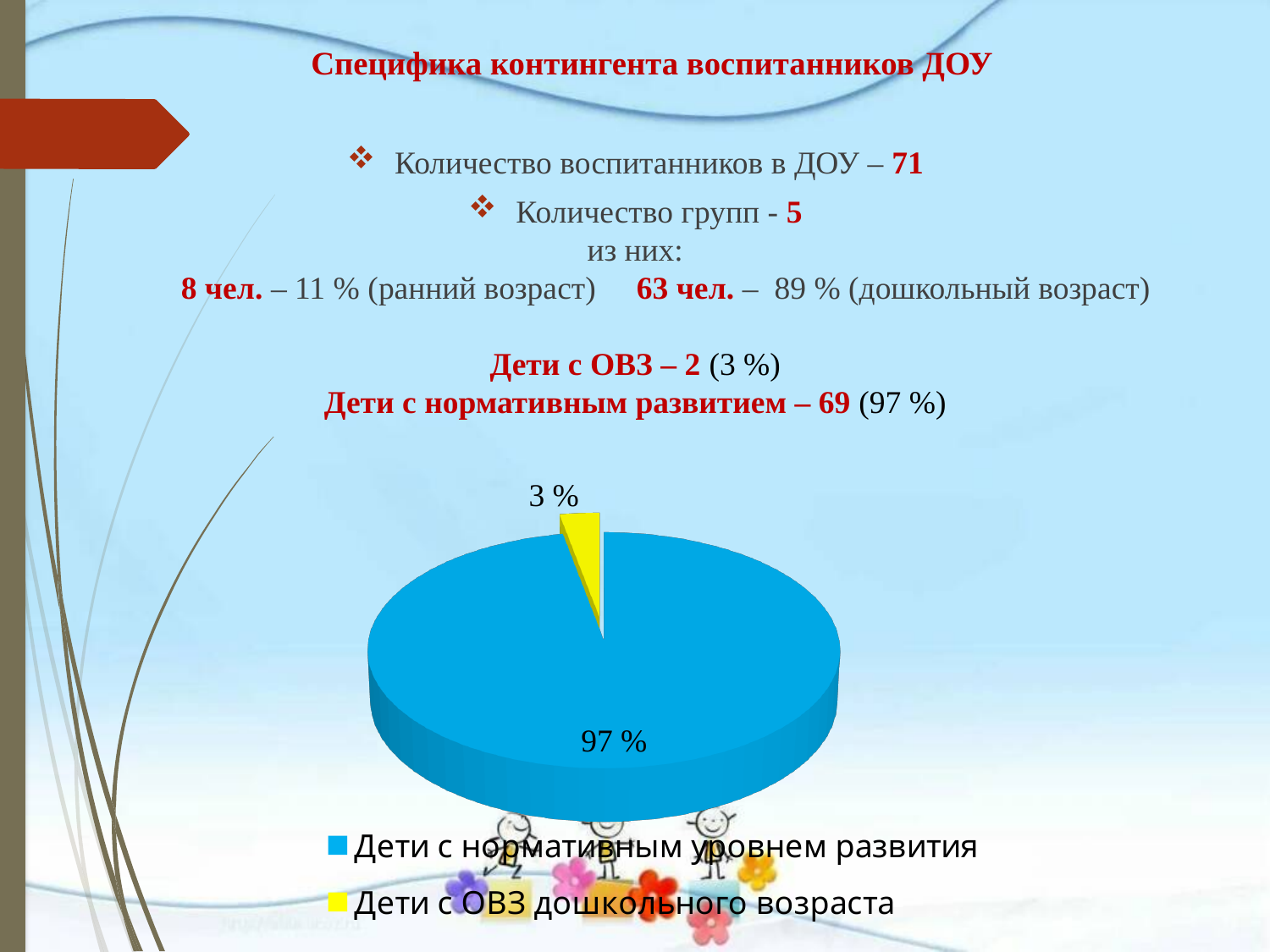
How many slices does the pie chart have? 2 What is the total of the two percentages shown on the pie chart? 100 % What share of the pie does the slice for "Дети с нормативным уровнем развития" represent? 97 % What is the difference in percentage points between the two slices of the pie chart? 94 Which slice is larger: "Дети с нормативным уровнем развития" or "Дети с ОВЗ дошкольного возраста"? Дети с нормативным уровнем развития What share of the pie does the slice for "Дети с ОВЗ дошкольного возраста" represent? 3 % How many entries does the legend of the pie chart list? 2 What kind of chart is shown on the slide? pie chart Which category has the smallest slice in the pie chart? Дети с ОВЗ дошкольного возраста What colour is the slice for "Дети с ОВЗ дошкольного возраста"? yellow Which category has the largest slice in the pie chart? Дети с нормативным уровнем развития What colour is the slice for "Дети с нормативным уровнем развития"? blue